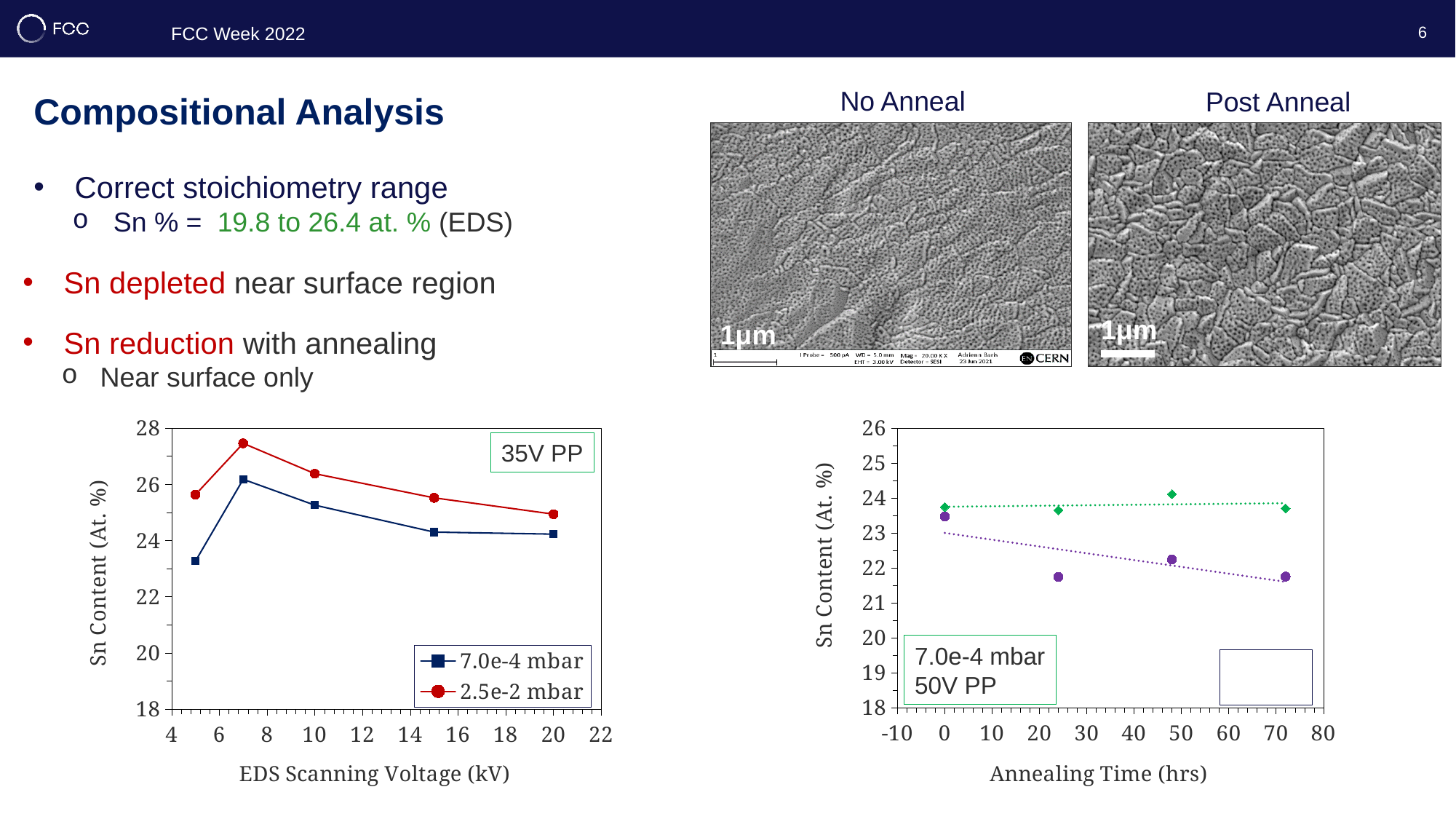
In the 35V PP chart on the left, does the Sn content of the 2.5e-2 mbar series rise or fall from 7 kV to 20 kV? fall In the chart on the right (Sn Content vs Annealing Time), is the purple circle value at 24 hrs greater or less than 22? less In the 35V PP chart on the left, which series has the higher Sn content at 10 kV? 2.5e-2 mbar In the 35V PP chart on the left, at which EDS scanning voltage is the 7.0e-4 mbar series lowest? 5 kV In the 35V PP chart on the left, how many series does the legend list? 2 In the 35V PP chart on the left, at which EDS scanning voltage is the 2.5e-2 mbar series highest? 7 kV In the 35V PP chart on the left, is the Sn content of the 7.0e-4 mbar series at 5 kV greater or less than 24? less In the 35V PP chart on the left, how many data points does the 7.0e-4 mbar series have? 5 In the 35V PP chart on the left, what kind of chart is it? line chart In the chart on the right (Sn Content vs Annealing Time), what is the x-axis label? Annealing Time (hrs) In the chart on the right (Sn Content vs Annealing Time), how many purple circle data points are plotted? 4 In the 35V PP chart on the left, is the Sn content of the 2.5e-2 mbar series at 7 kV greater or less than 26? greater